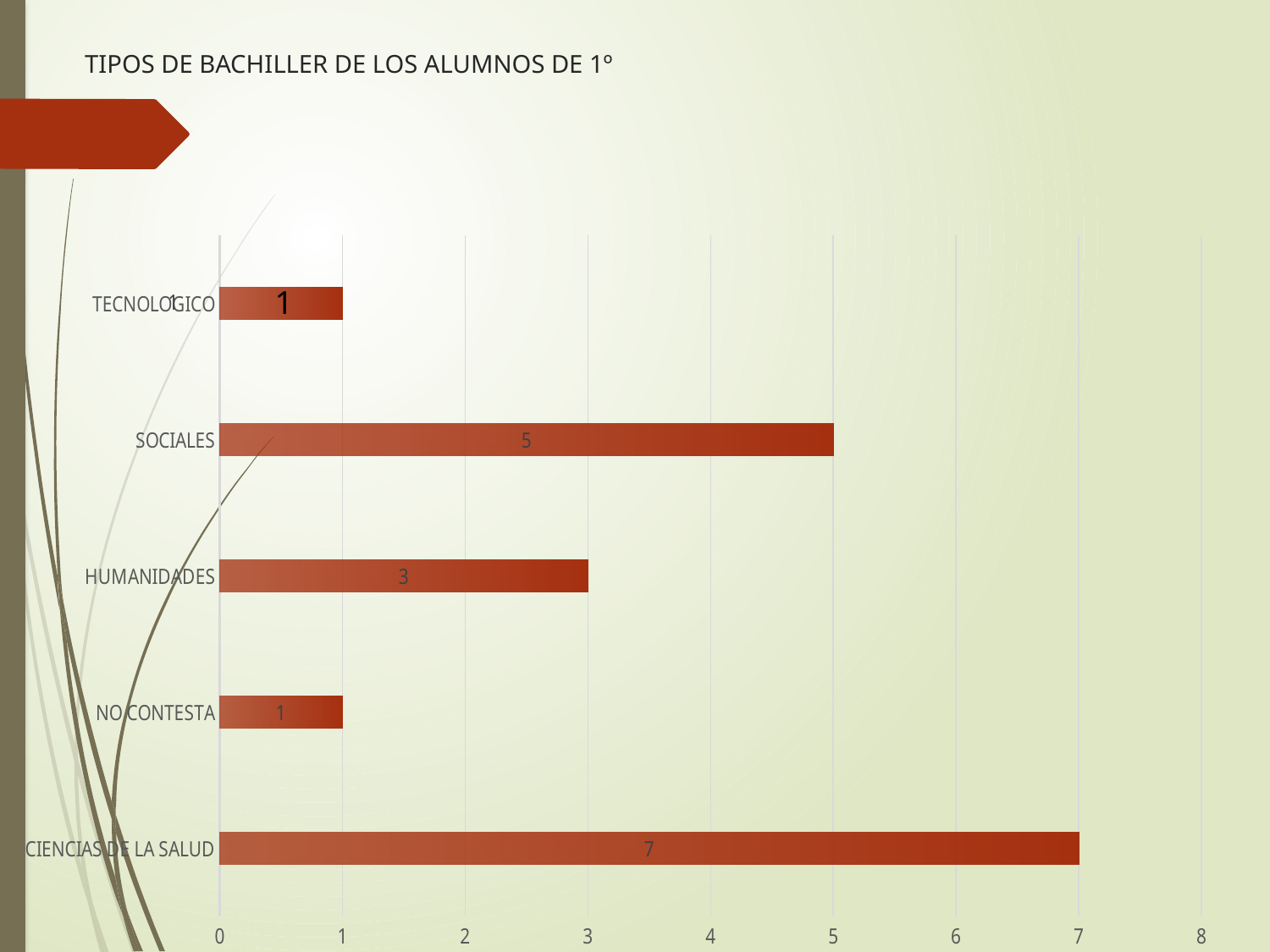
What is the difference between the values for CIENCIAS DE LA SALUD and SOCIALES? 2 Which category has the highest value? CIENCIAS DE LA SALUD What is the value for SOCIALES? 5 How many categories are shown in the chart? 5 What is the title of the slide? TIPOS DE BACHILLER DE LOS ALUMNOS DE 1º What is the value for NO CONTESTA? 1 What is the value for HUMANIDADES? 3 What is the difference between the values for SOCIALES and HUMANIDADES? 2 Which is larger, the value for HUMANIDADES or the value for SOCIALES? SOCIALES What is the value for CIENCIAS DE LA SALUD? 7 Is the value for CIENCIAS DE LA SALUD greater or less than 6? greater What kind of chart is shown on the slide? bar chart